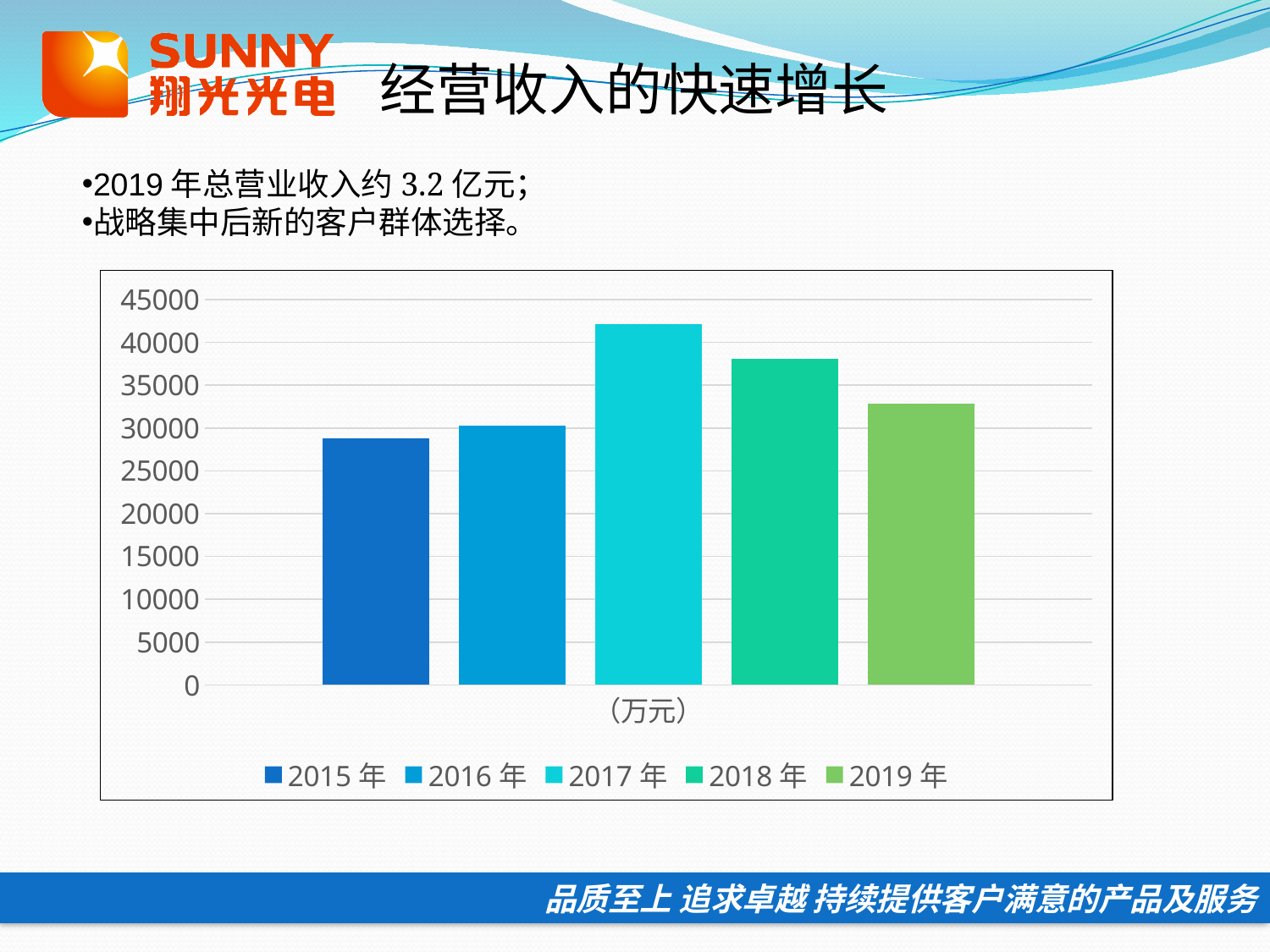
What is the highest value shown on the y axis? 45000 Which year has the lowest bar? 2015 年 What unit label is shown below the bars on the x axis? （万元） Which is larger, the value for 2019 年 or the value for 2016 年? 2019 年 Is the value for 2015 年 greater or less than 30000? less How many series does the legend list? 5 Which year has the highest bar? 2017 年 Is the value for 2018 年 greater or less than 35000? greater Which is larger, the value for 2017 年 or the value for 2018 年? 2017 年 Is the value for 2019 年 greater or less than 35000? less What kind of chart is shown on the slide? bar chart